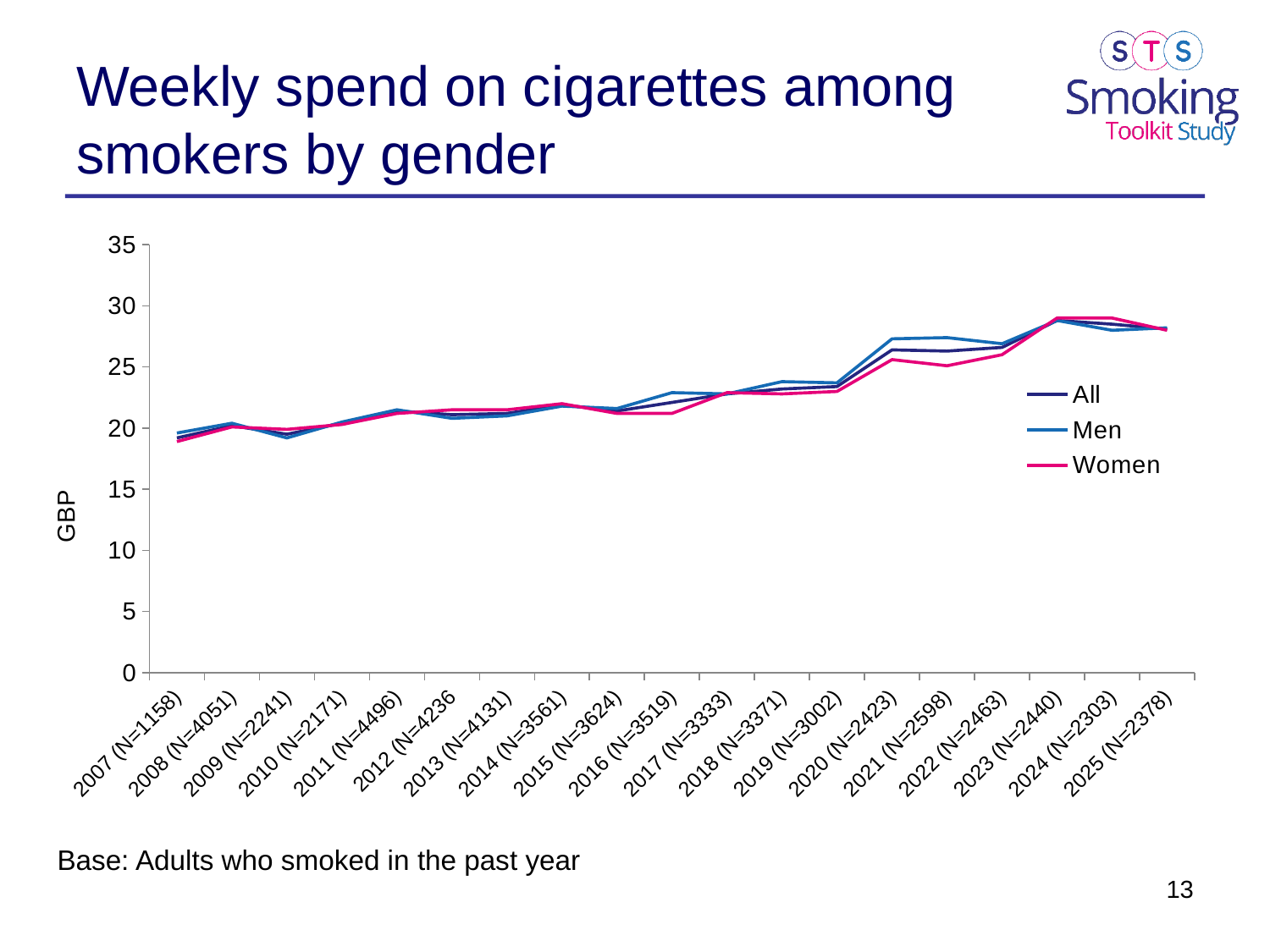
Is the value for Women in 2007 (N=1158) greater or less than 20? less Is the value for Women in 2016 (N=3519) greater or less than 25? less In 2022 (N=2463), which is larger, the value for Men or the value for Women? Men What is the title of the chart on the slide? Weekly spend on cigarettes among smokers by gender Overall, do the values for All rise or fall from 2007 to 2025? Rise What is the label on the y axis? GBP How many years are plotted along the x axis? 19 What kind of chart is shown on the slide? Line chart Is the value for All in 2025 (N=2378) greater or less than 25? greater How many series does the legend list? 3 In 2021 (N=2598), which is larger, the value for Men or the value for Women? Men